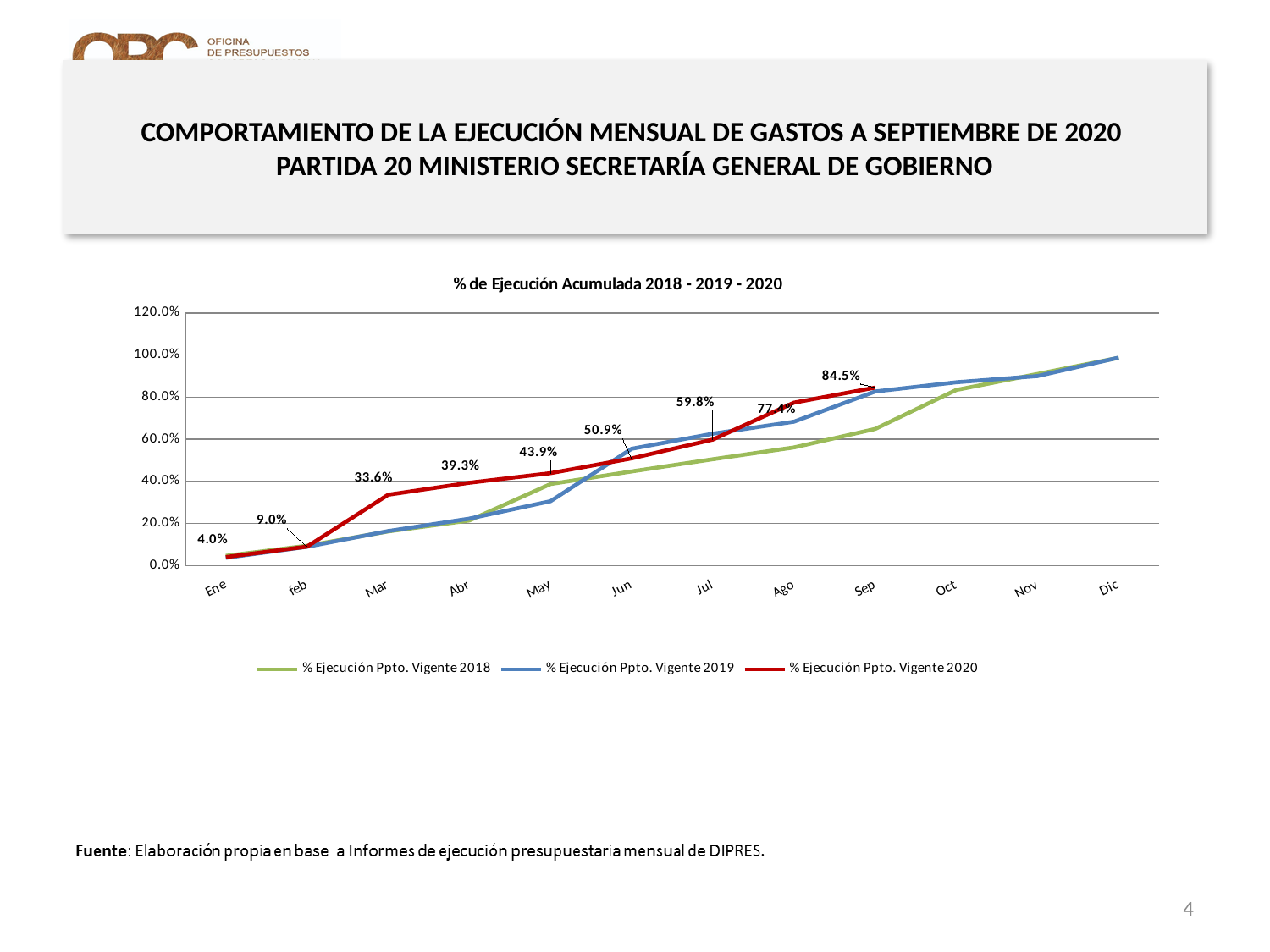
What is the difference between the % Ejecución Ppto. Vigente 2020 values for Jul and Jun? 8.9% Is the value for % Ejecución Ppto. Vigente 2018 in Sep greater or less than 80.0%? less What type of chart is shown on the slide? line chart Does the % Ejecución Ppto. Vigente 2020 series rise or fall from Ene to Sep? rise In Mar, which series is larger: % Ejecución Ppto. Vigente 2020 or % Ejecución Ppto. Vigente 2019? % Ejecución Ppto. Vigente 2020 What is the value for % Ejecución Ppto. Vigente 2020 in Ene? 4.0% How many series does the legend list? 3 How many months are shown on the x axis? 12 What is the title of the chart? % de Ejecución Acumulada 2018 - 2019 - 2020 What is the value for % Ejecución Ppto. Vigente 2020 in Sep? 84.5% Which colour is used for the % Ejecución Ppto. Vigente 2020 line? red What is the value for % Ejecución Ppto. Vigente 2020 in Mar? 33.6%